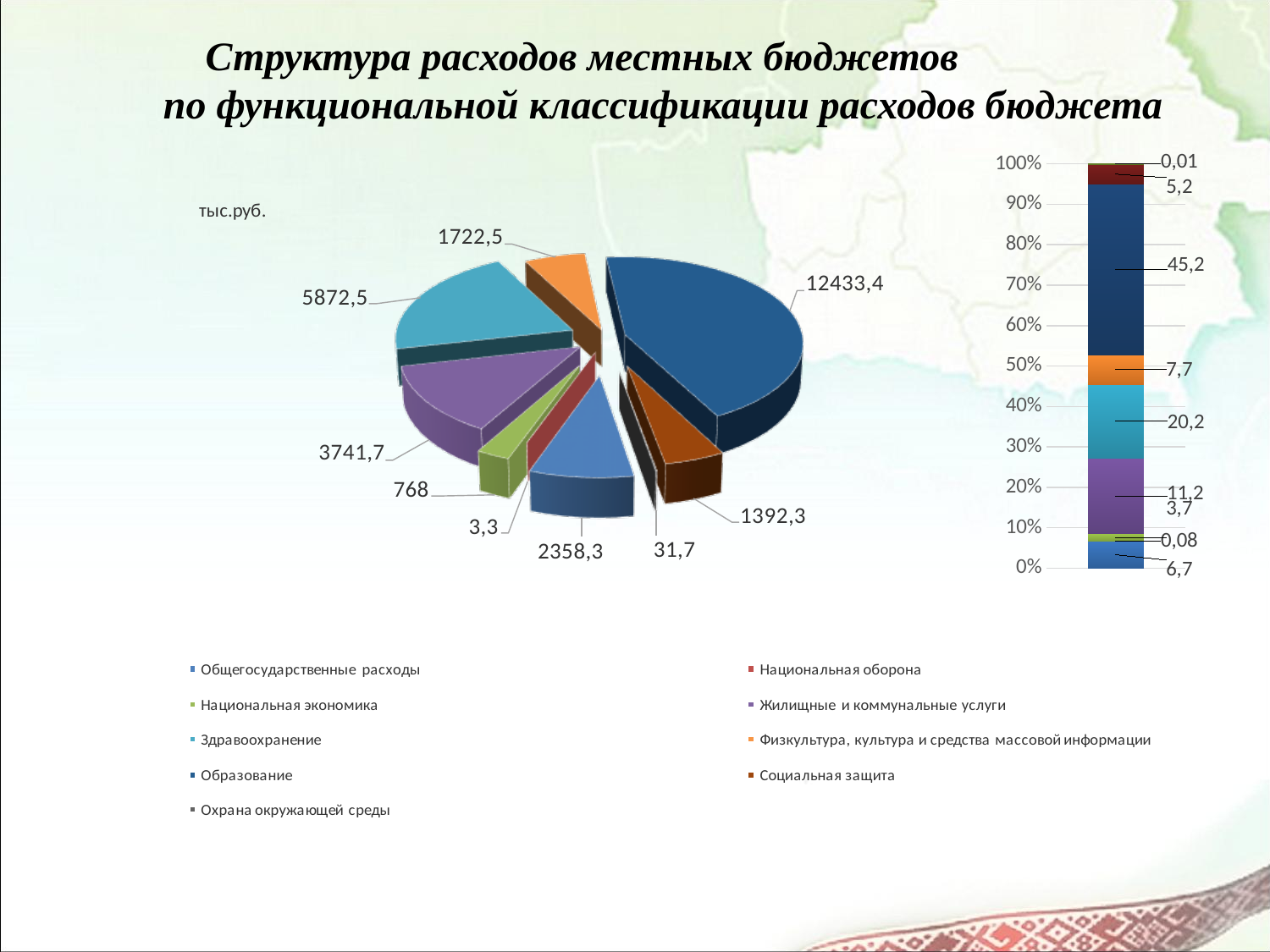
What kind of chart is the chart on the right of the slide? bar chart In the stacked bar chart on the right, what is the value for Здравоохранение? 20,2 In the pie chart on the left, what is the largest labelled value? 12433,4 How many slices does the pie chart on the left have? 9 In the stacked bar chart on the right, what is the largest segment value? 45,2 In the pie chart on the left, what is the difference between the values for Здравоохранение (5872,5) and Жилищные и коммунальные услуги (3741,7)? 2130,8 In the pie chart on the left, what is the value for Здравоохранение? 5872,5 How many categories does the legend list? 9 In the pie chart on the left, what is the smallest labelled value? 3,3 In the pie chart on the left, what is the value for Образование? 12433,4 What kind of chart is the chart on the left of the slide? pie chart In the pie chart on the left, which is larger: Общегосударственные расходы or Физкультура, культура и средства массовой информации? Общегосударственные расходы